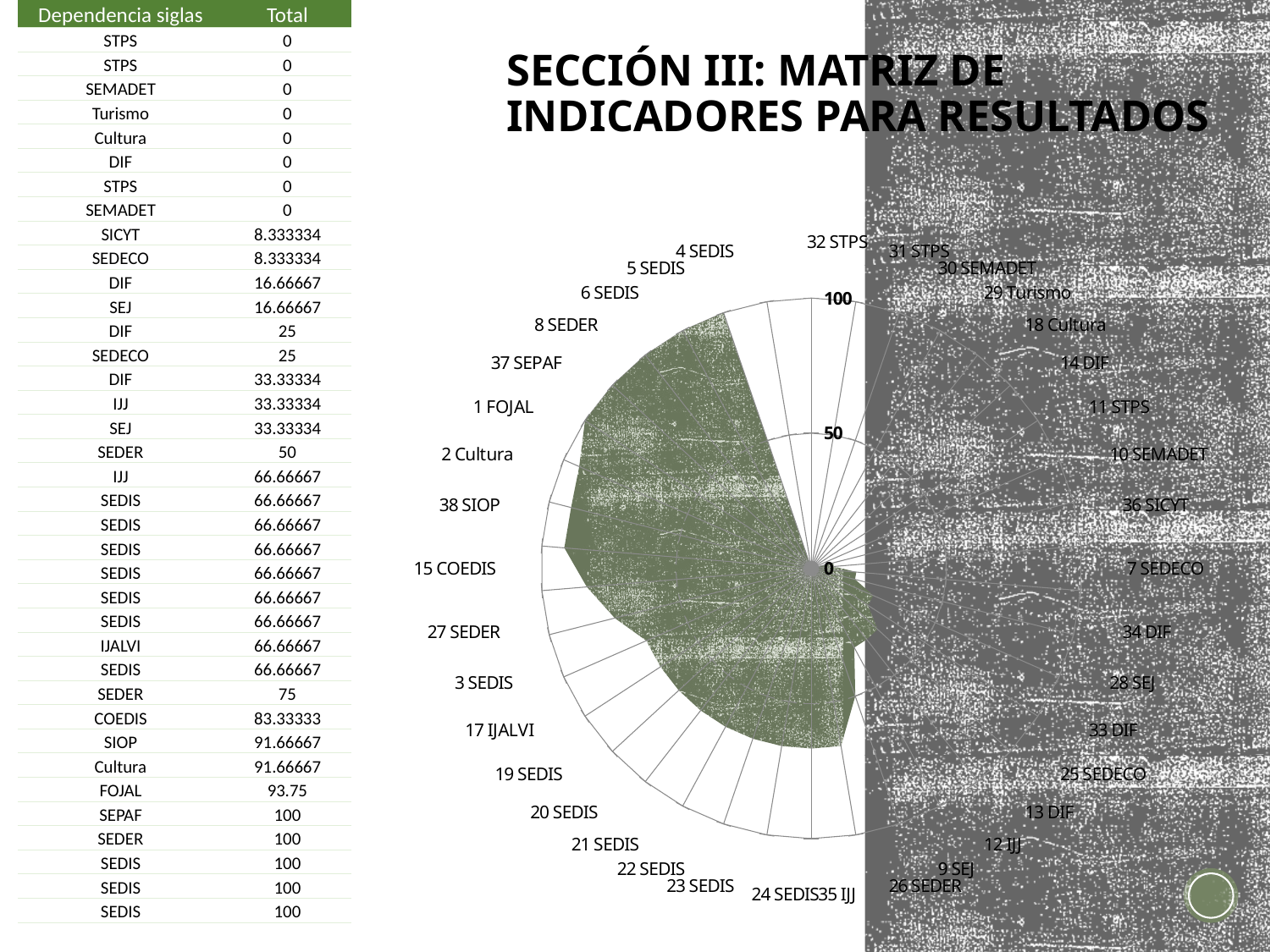
What is the highest value marked on the chart's radial axis? 100 Is the value for 32 STPS greater or less than 50? less Is the value for 25 SEDECO greater or less than 50? less Is the value for 15 COEDIS greater or less than 50? greater Which is larger, the value for 4 SEDIS or the value for 32 STPS? 4 SEDIS What kind of chart is shown on the slide? radar chart According to the table on the left, what is the Total for FOJAL? 93.75 Which is larger, the value for 15 COEDIS or the value for 25 SEDECO? 15 COEDIS According to the table on the left, what is the Total for COEDIS? 83.33333